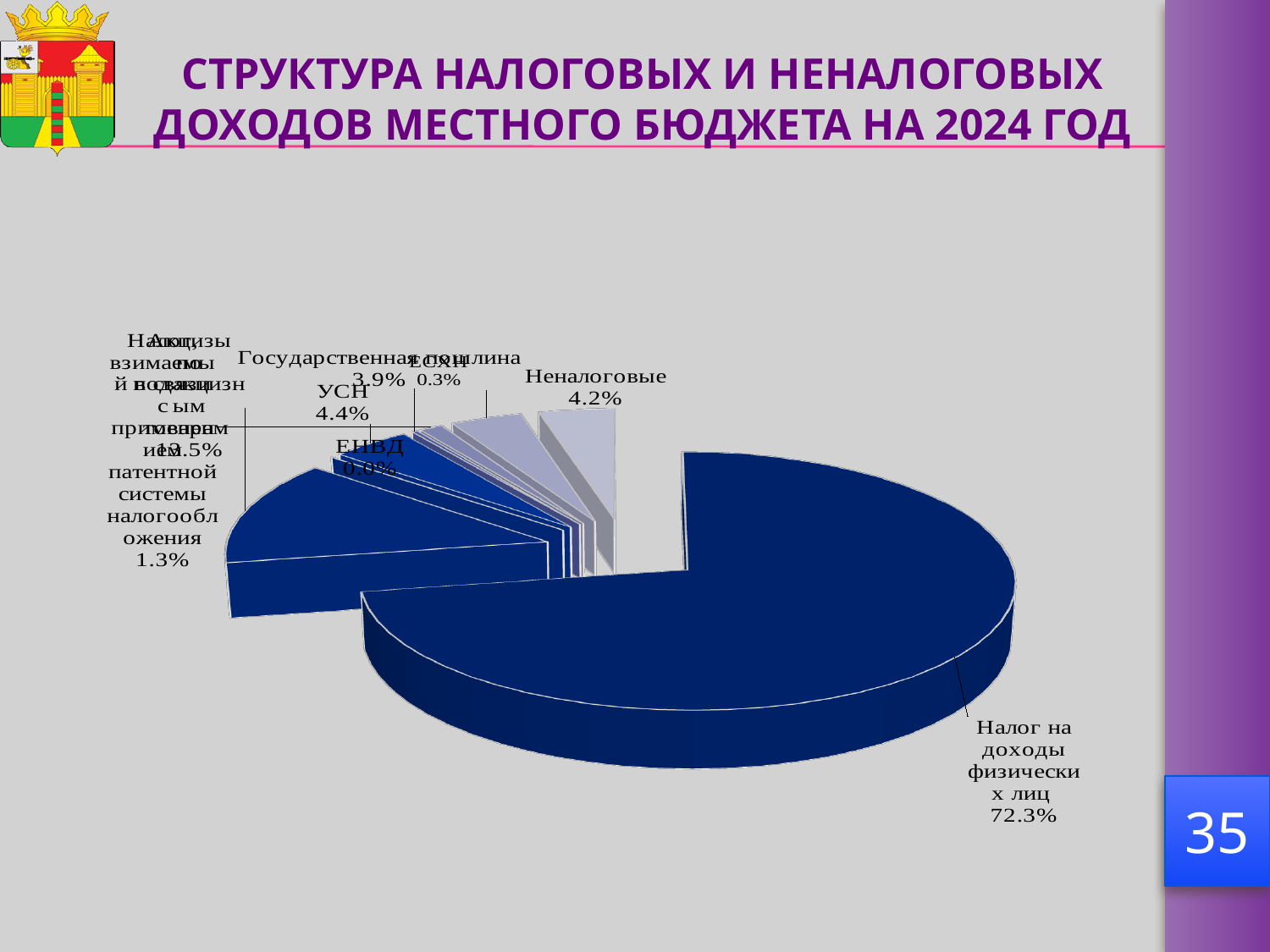
What percentage is shown for "Государственная пошлина"? 3.9% Which category has the smallest share of the pie? ЕНВД What kind of chart is shown on the slide? pie chart What is the difference between the share for "Неналоговые" and the share for "Государственная пошлина"? 0.3% What share of the pie is labelled for "Налог на доходы физических лиц"? 72.3% What percentage is shown for "УСН"? 4.4% Which category has the largest share of the pie? Налог на доходы физических лиц What percentage is shown for "ЕСХН"? 0.3% Which is larger, the share for "УСН" or the share for "Государственная пошлина"? УСН What percentage is shown for "ЕНВД"? 0.0% What percentage is shown for the tax related to the patent system of taxation (патентной системы налогообложения)? 1.3% What percentage is shown for "Неналоговые"? 4.2%